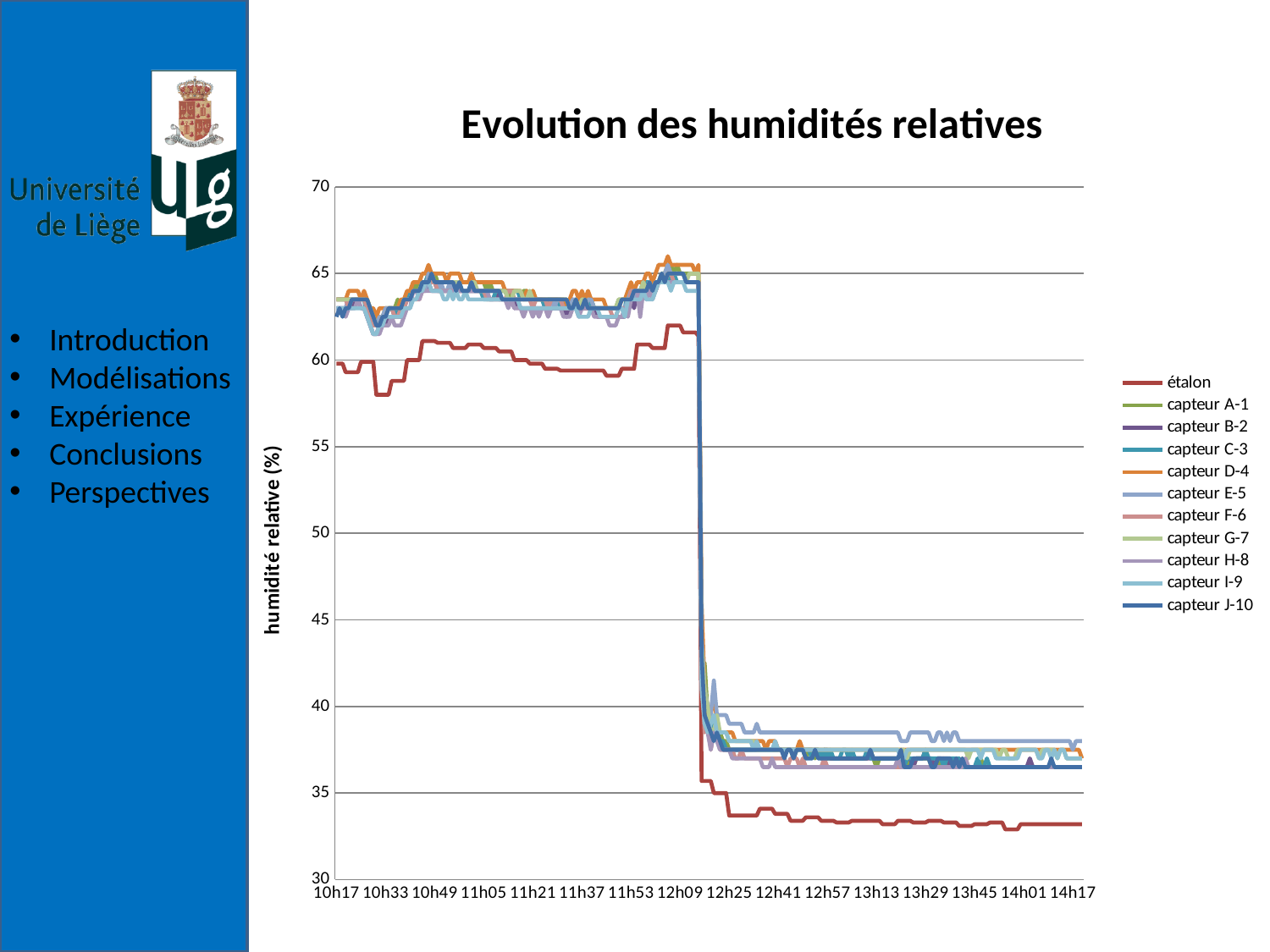
What is the label of the vertical axis? humidité relative (%) At 14h17, which is higher: the étalon series or capteur E-5? capteur E-5 Is the value of the étalon series at 14h17 greater or less than 35? less Which series is drawn in red? étalon Overall, do the humidity values rise or fall between 10h17 and 14h17? fall Is the value of capteur E-5 at 14h17 greater or less than 35? greater What is the title of the chart? Evolution des humidités relatives Is the value of capteur D-4 at 10h49 greater or less than 60? greater What kind of chart is shown on the slide? line chart How many series does the legend list? 11 At 10h17, which is higher: the étalon series or capteur D-4? capteur D-4